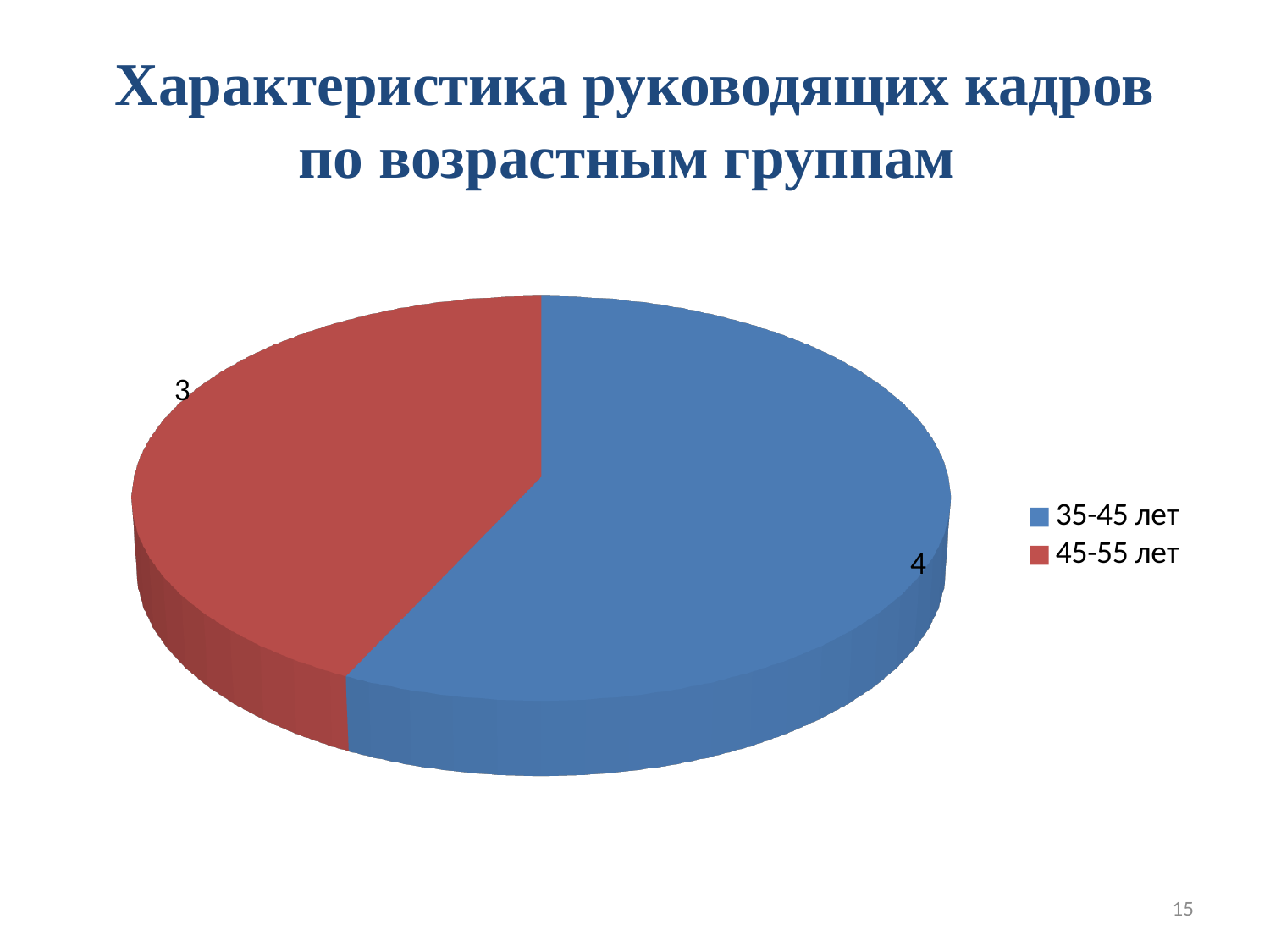
What is the value for the 45-55 лет slice? 3 Which age group has the smallest slice? 45-55 лет Which age group has the largest slice? 35-45 лет What type of chart is shown on the slide? pie chart What is the value for the 35-45 лет slice? 4 What colour is the slice for 45-55 лет? red How many entries does the legend list? 2 Which is larger, the value for 35-45 лет or for 45-55 лет? 35-45 лет What is the total of all slices in the pie chart? 7 How many slices does the pie chart have? 2 What is the difference between the values for 35-45 лет and 45-55 лет? 1 What is the title of the slide containing the chart? Характеристика руководящих кадров по возрастным группам